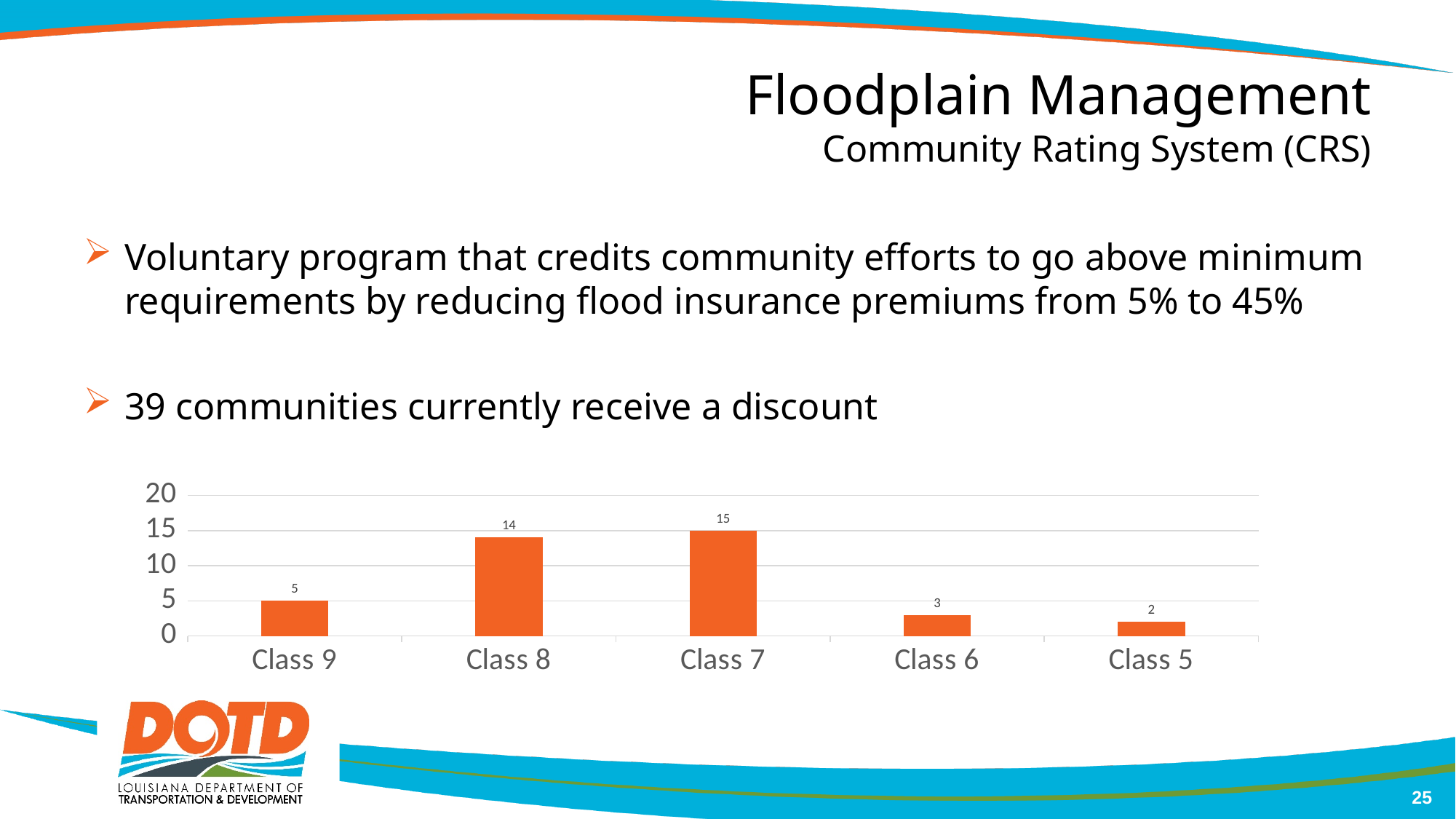
What is the value for Class 6? 3 Which class has the lowest value? Class 5 How many classes are shown on the x axis of the chart? 5 What colour are the bars in the chart? Orange Which class has the highest value? Class 7 What is the difference between the values for Class 7 and Class 9? 10 What is the value for Class 9? 5 What is the value for Class 7? 15 What kind of chart is shown on the slide? Bar chart What is the value for Class 8? 14 Which is larger, the value for Class 8 or the value for Class 6? Class 8 What is the value for Class 5? 2